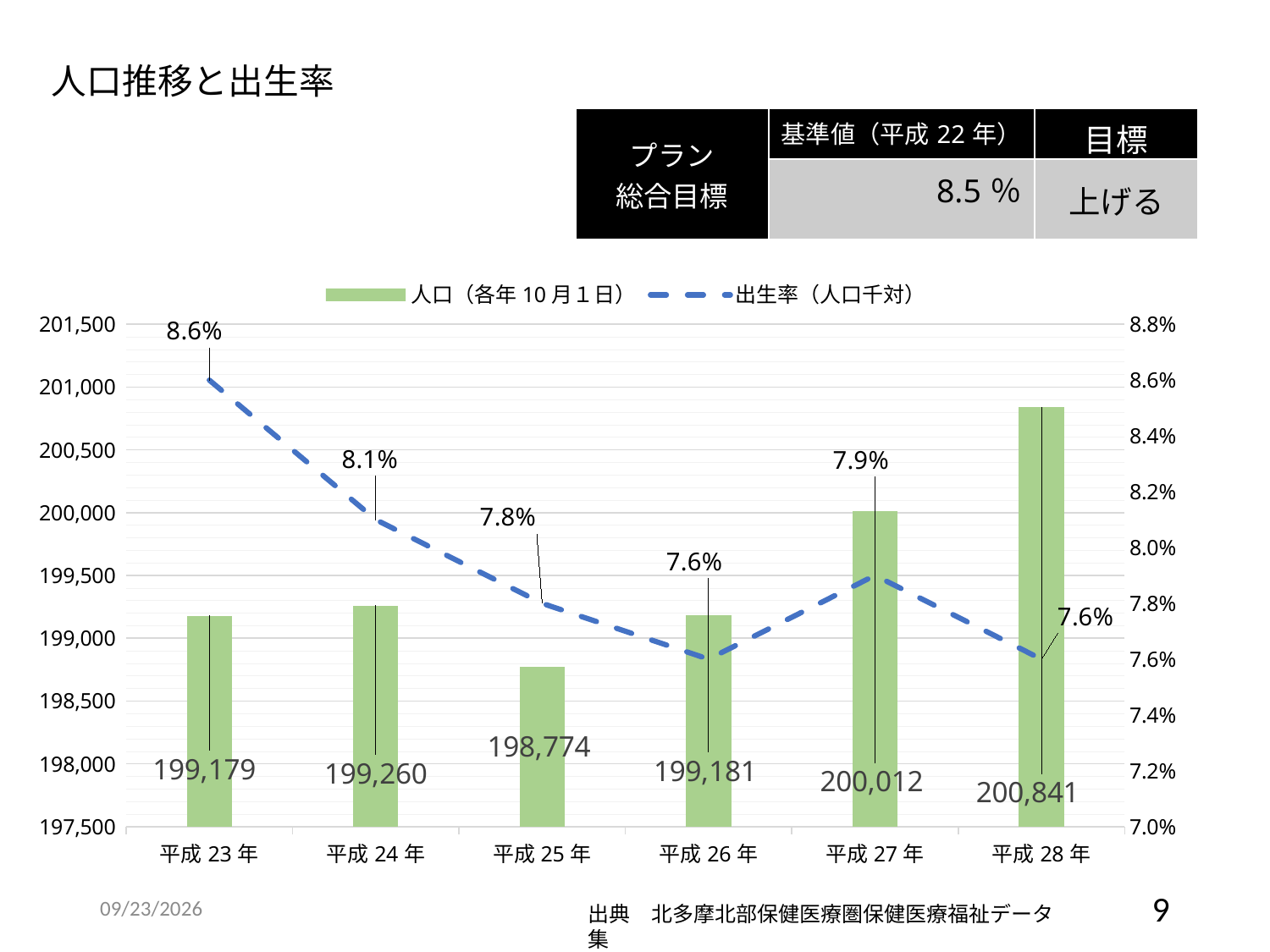
Which is larger, the population in 平成24年 or in 平成26年? 平成24年 How many years are shown on the x axis? 6 Which year has the highest population (人口)? 平成28年 Does the birth rate (出生率) rise or fall from 平成23年 to 平成26年? fall What is the difference in population between 平成28年 and 平成27年? 829 How many series does the legend list? 2 What is the birth rate (出生率) for 平成27年? 7.9% What is the population (人口) value for 平成25年? 198,774 Which year has the lowest population (人口)? 平成25年 What is the difference in birth rate between 平成23年 and 平成24年? 0.5% What is the baseline value (基準値, 平成22年) shown in the table above the chart? 8.5 % Which year has the highest birth rate (出生率)? 平成23年